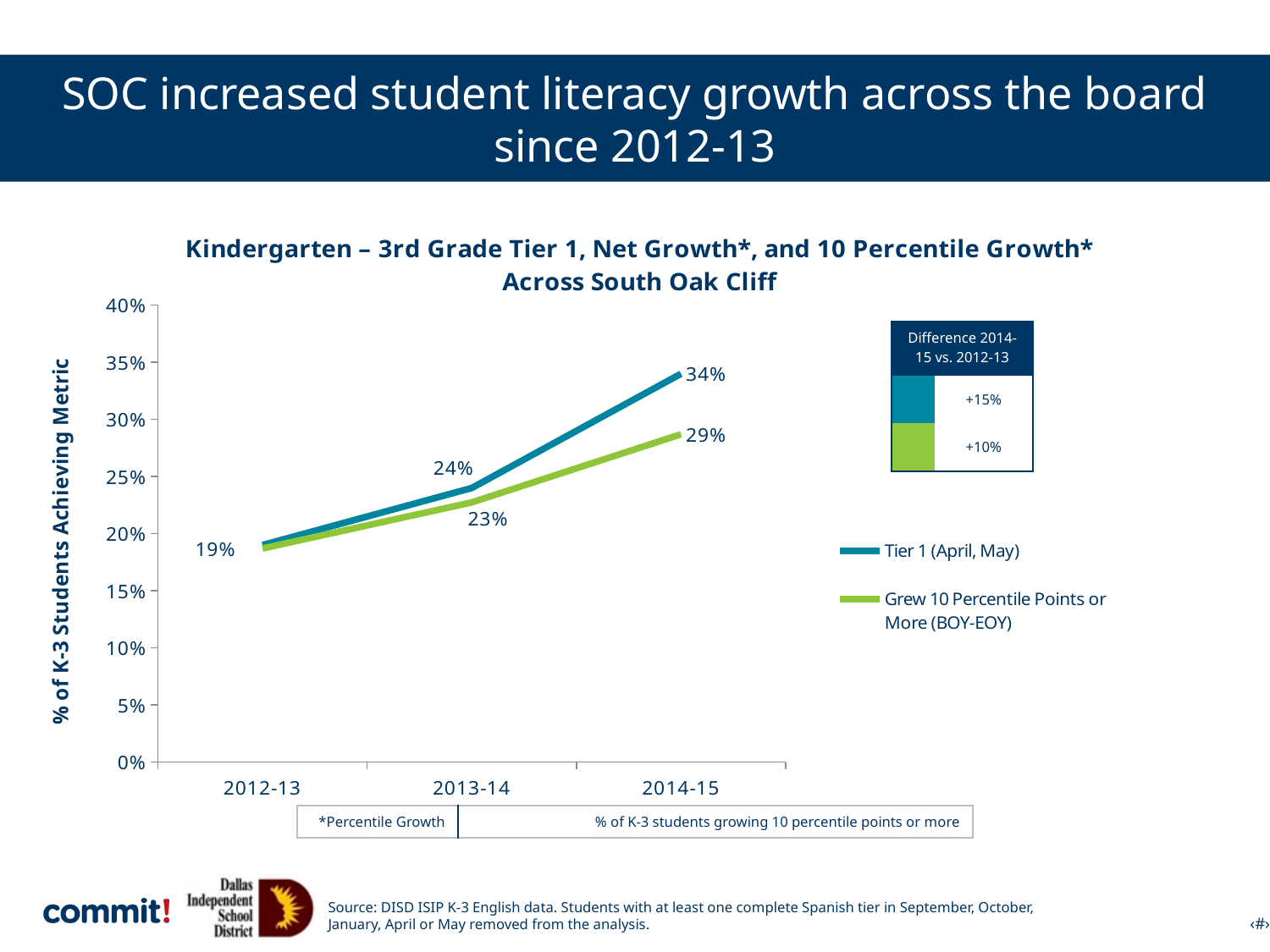
What is the value for Grew 10 Percentile Points or More (BOY-EOY) in 2013-14? 23% How many series does the legend list? 2 What is the Tier 1 (April, May) value for 2013-14? 24% Do the Tier 1 (April, May) values rise or fall from 2012-13 to 2014-15? rise What is the value for Grew 10 Percentile Points or More (BOY-EOY) in 2014-15? 29% Which series has the larger value in 2014-15, Tier 1 (April, May) or Grew 10 Percentile Points or More (BOY-EOY)? Tier 1 (April, May) What type of chart is shown on the slide? line chart According to the box on the chart, what is the difference for Tier 1 between 2014-15 and 2012-13? +15% What is the Tier 1 (April, May) value for 2014-15? 34% How many school years are plotted on the x axis? 3 What is the difference between the Tier 1 (April, May) value and the Grew 10 Percentile Points or More value in 2014-15? 5% In which year is the Tier 1 (April, May) value highest? 2014-15